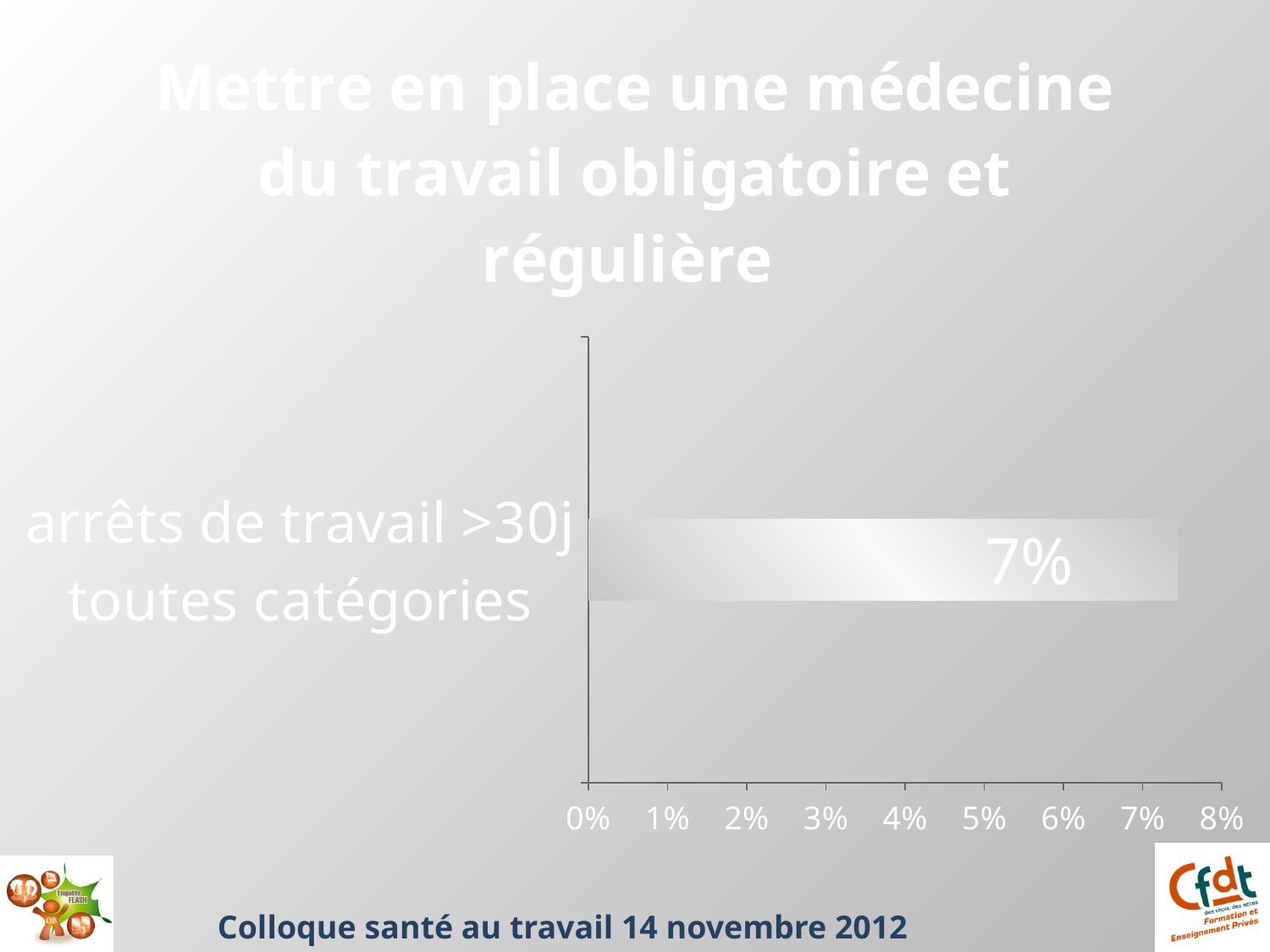
Is the value for "arrêts de travail >30j toutes catégories" greater or less than 8%? less What kind of chart is shown on the slide? bar chart What is the label of the category plotted in the chart? arrêts de travail >30j toutes catégories What is the title of the slide containing the chart? Mettre en place une médecine du travail obligatoire et régulière Is the value for "arrêts de travail >30j toutes catégories" greater or less than 5%? greater What is the value shown for "arrêts de travail >30j toutes catégories"? 7% How many categories are plotted in the chart? 1 What is the maximum value shown on the horizontal axis of the chart? 8%